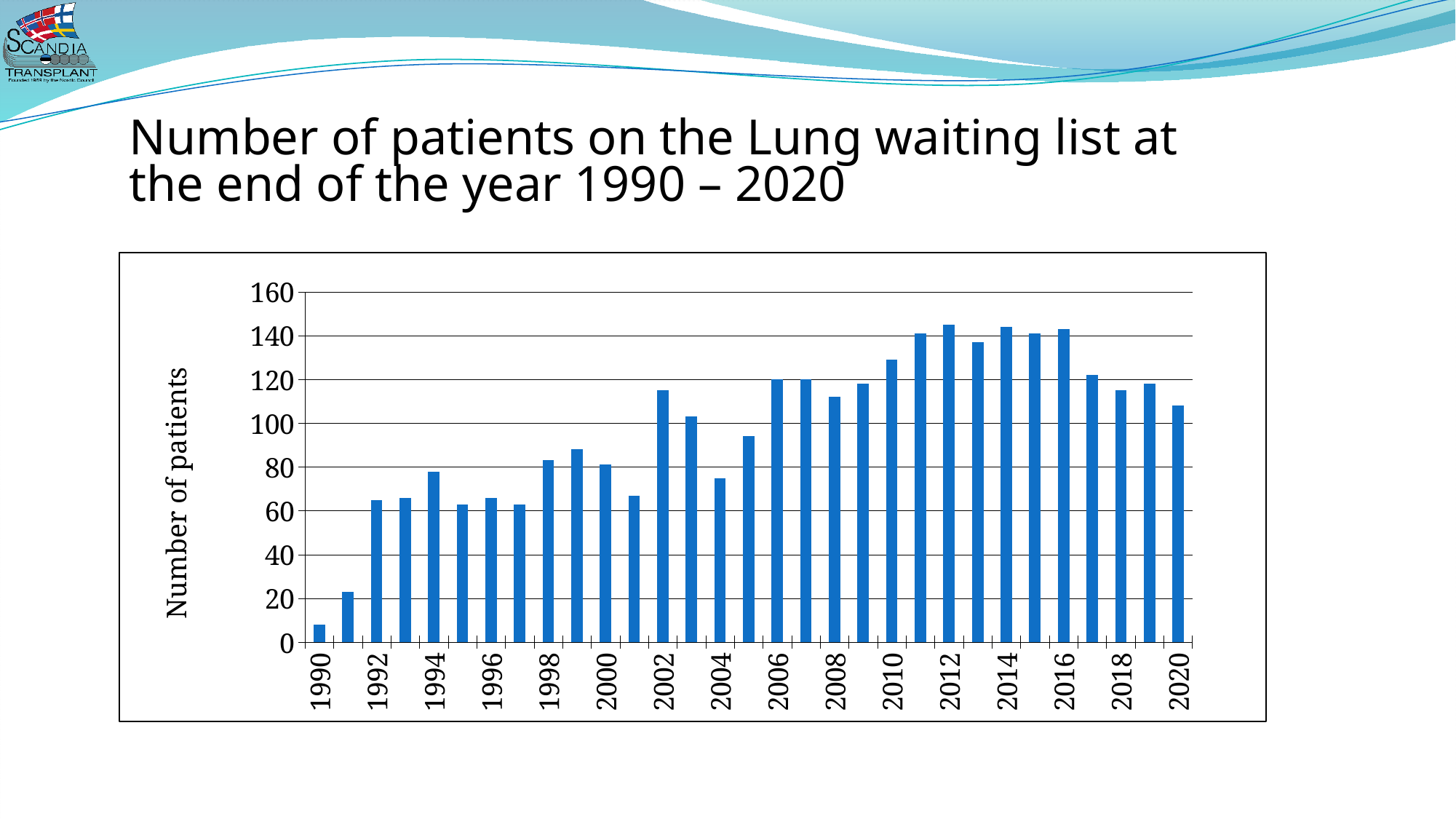
What is the label on the vertical axis of the chart? Number of patients Is the value for 2020 greater or less than 100? greater Is the value for 1990 greater or less than 20? less Which year has the lowest number of patients on the lung waiting list? 1990 How many years (bars) are plotted in the chart? 31 Is the value for 2010 greater or less than 120? greater What kind of chart is shown on the slide? bar chart Which year has the larger value, 1999 or 2001? 1999 Do the values rise or fall from 2016 to 2020? fall Which year has the larger value, 2002 or 2004? 2002